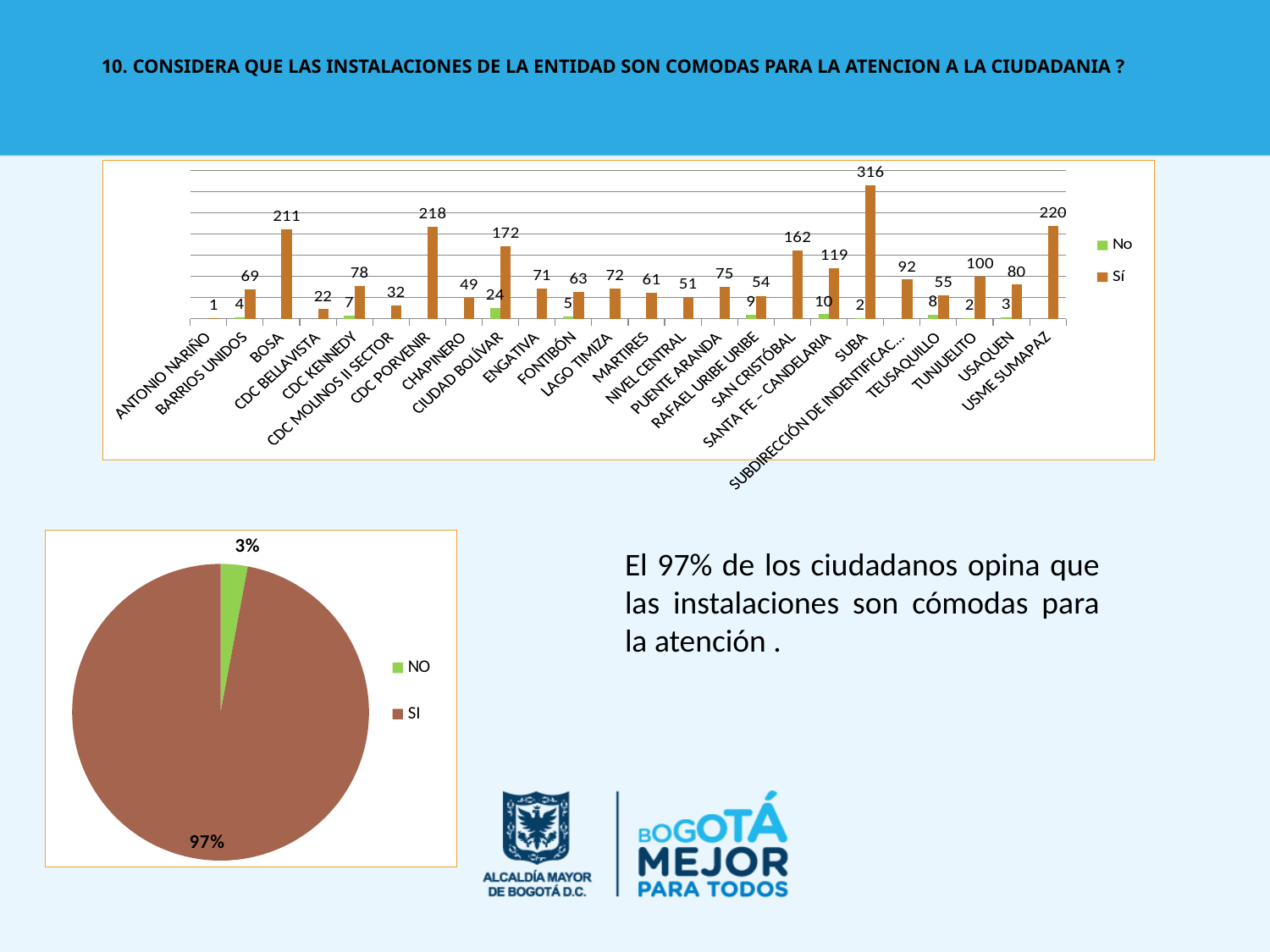
In the bar chart, what is the 'Sí' value for SUBA? 316 In the bar chart, what is the 'No' value for CIUDAD BOLÍVAR? 24 In the bar chart, what is the 'Sí' value for USME SUMAPAZ? 220 In the bar chart, what is the 'Sí' value for BOSA? 211 How many series does the legend of the bar chart list? 2 What kind of chart is the chart at the top of the slide? Bar chart In the pie chart, what share does the 'SI' slice have? 97% In the bar chart, which has a larger 'Sí' value, CDC PORVENIR or BOSA? CDC PORVENIR In the bar chart, what is the difference between the 'Sí' values for SUBA and USME SUMAPAZ? 96 In the pie chart, what share does the 'NO' slice have? 3% In the bar chart, how many categories are shown on the x axis? 24 In the bar chart, which category has the highest 'Sí' value? SUBA